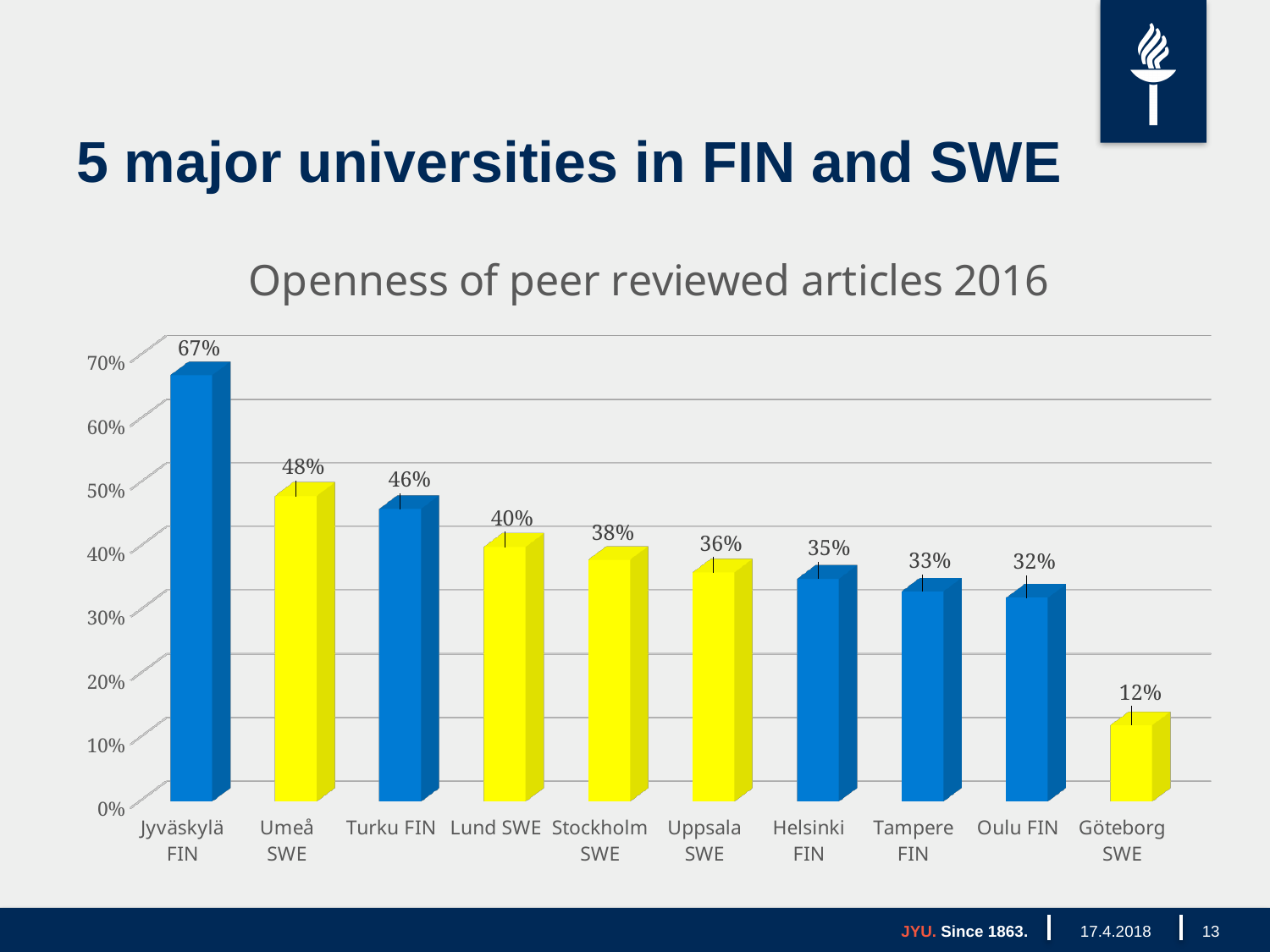
What is the difference between the values for Jyväskylä FIN and Umeå SWE? 19% What is the value for Stockholm SWE? 38% Do the values rise or fall from left to right along the x axis? fall What kind of chart is shown on the slide? bar chart What is the value for Göteborg SWE? 12% Which university has the highest openness of peer reviewed articles? Jyväskylä FIN How many universities are shown in the chart? 10 Is the value for Helsinki FIN greater or less than 40%? less Which is larger, the value for Turku FIN or the value for Lund SWE? Turku FIN What is the title of the chart? Openness of peer reviewed articles 2016 Which university has the lowest openness of peer reviewed articles? Göteborg SWE What is the value for Jyväskylä FIN? 67%